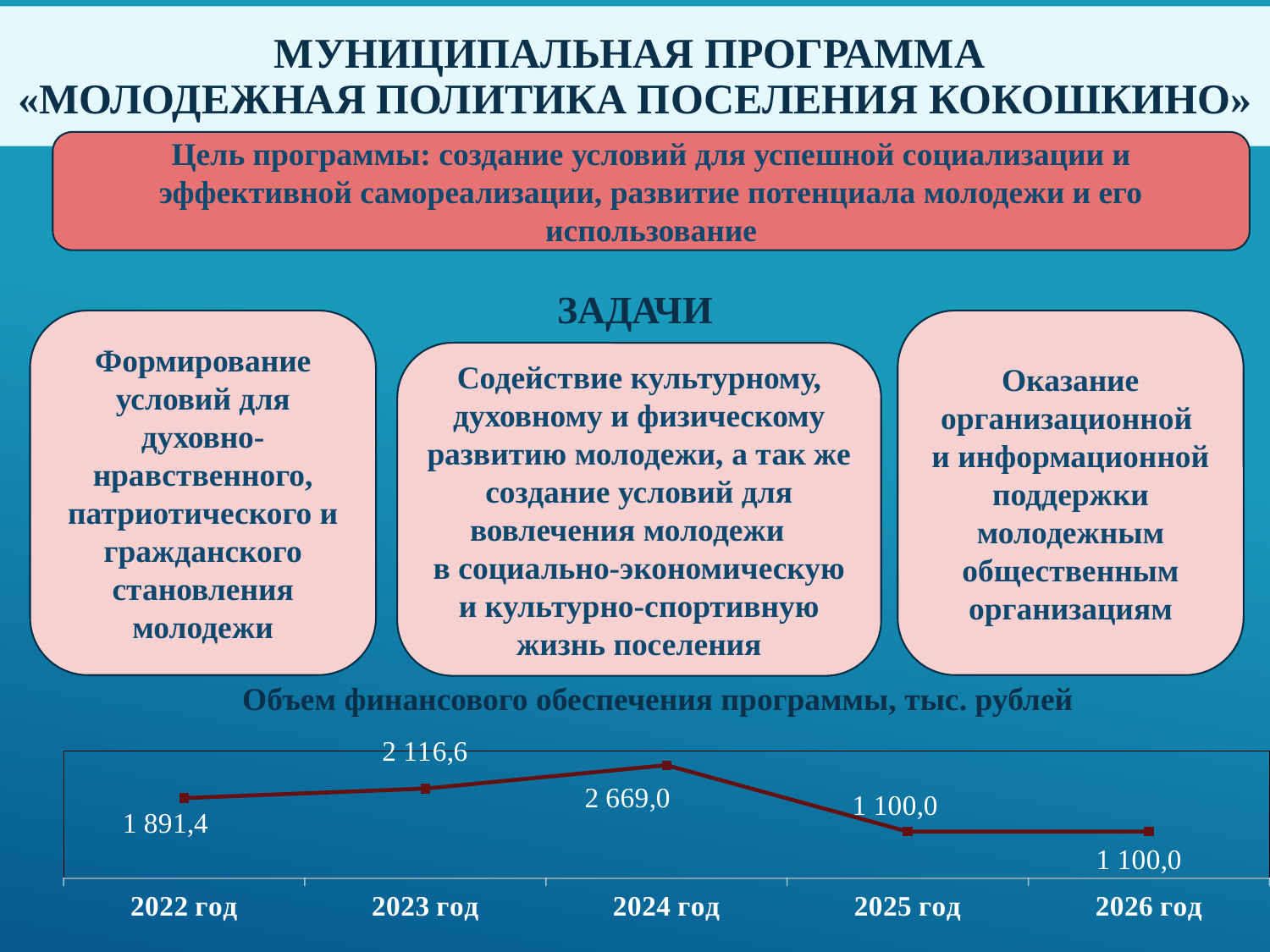
Do the values rise or fall from 2024 год to 2025 год? fall How many years are plotted on the chart? 5 Which is larger, the value for 2022 год or the value for 2023 год? 2023 год What is the value for 2022 год on the chart? 1 891,4 Which year has the highest value on the chart? 2024 год What is the difference between the values for 2024 год and 2023 год? 552,4 What is the value for 2025 год on the chart? 1 100,0 What is the value for 2024 год on the chart? 2 669,0 What is the difference between the values for 2023 год and 2022 год? 225,2 What is the value for 2023 год on the chart? 2 116,6 What kind of chart is shown on the slide? line chart What is the title of the chart? Объем финансового обеспечения программы, тыс. рублей